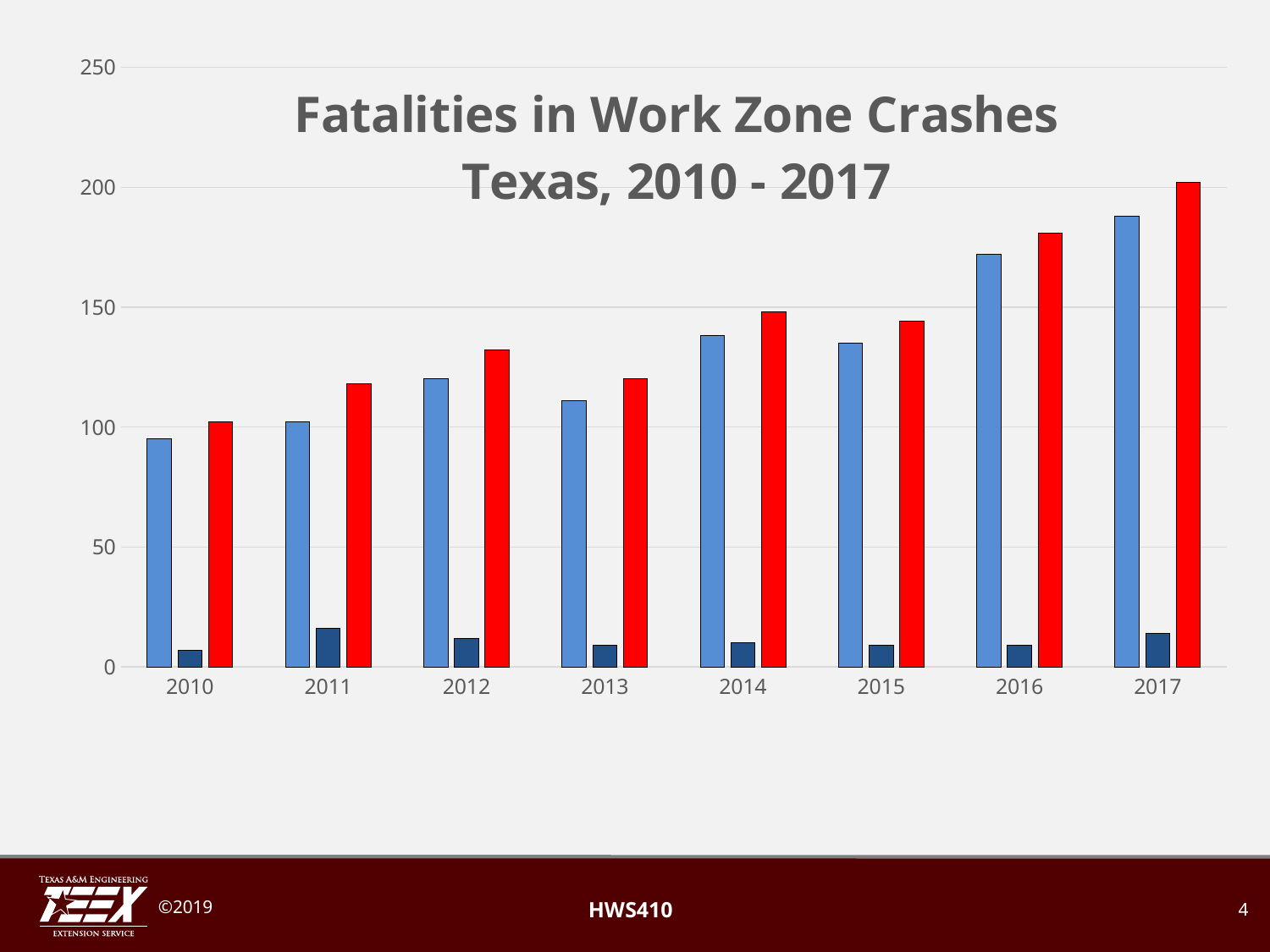
In which year is the light blue bar the tallest? 2017 How many years are shown along the x axis of the chart? 8 In which year is the red bar the tallest? 2017 Is the value of the light blue bar for 2010 greater or less than 100? less Is the value of the red bar for 2016 greater or less than 150? greater What is the title of the chart? Fatalities in Work Zone Crashes Texas, 2010 - 2017 For 2016, which is larger: the red bar or the light blue bar? the red bar In which year is the light blue bar the shortest? 2010 What kind of chart is shown on the slide? bar chart Do the red bars generally rise or fall from 2010 to 2017? rise In which year is the red bar the shortest? 2010 Is the value of the dark blue bar for 2014 greater or less than 50? less